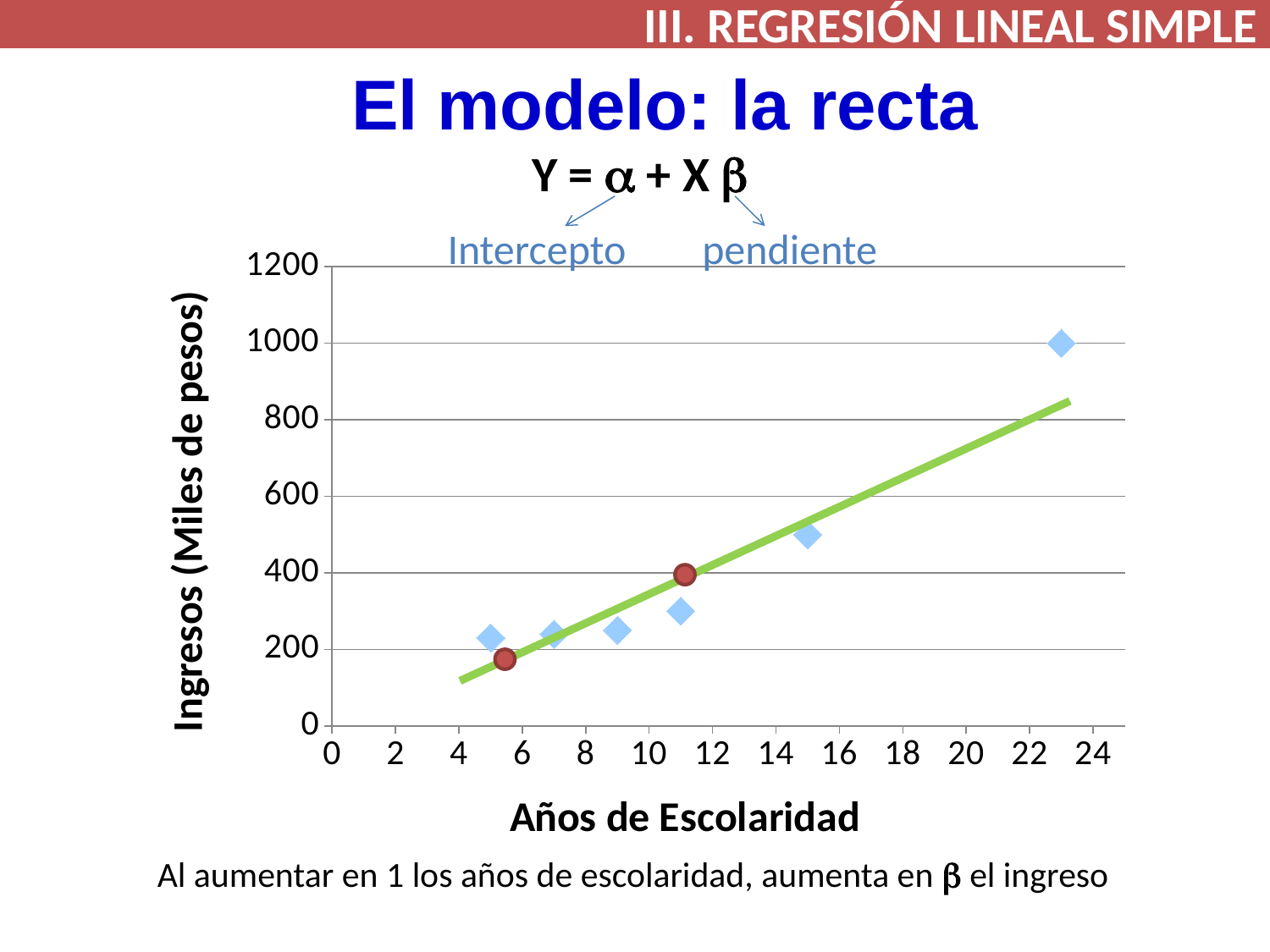
Is the income value for the point at 11 years of schooling greater or less than 400? less Is the income value for the point at 23 years of schooling greater or less than 800? greater What is the title of the y axis? Ingresos (Miles de pesos) How many blue diamond data points are plotted on the chart? 6 What is the title of the x axis? Años de Escolaridad Do the plotted income values rise or fall as years of schooling increase along the x axis? rise What kind of chart is shown on the slide? scatter chart Is the income value for the point at 15 years of schooling greater or less than 600? less Which has the larger income value: the point at 15 years of schooling or the point at 11 years of schooling? 15 years At which number of years of schooling is the plotted income highest? 23